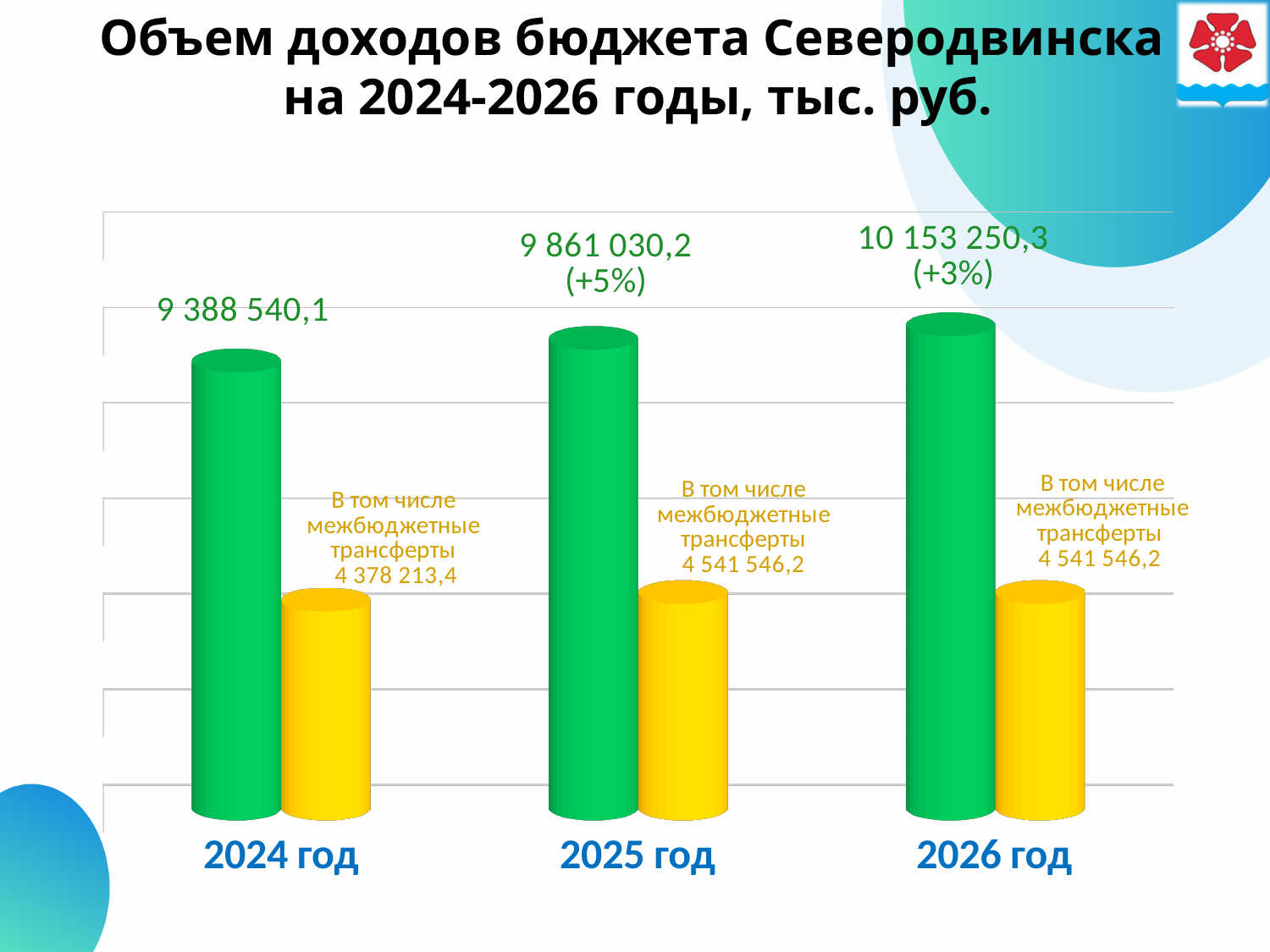
Do the total budget revenue values rise or fall from 2024 год to 2026 год? Rise What percentage growth is shown next to the 2025 год total revenue? +5% Which year has the lowest total budget revenue? 2024 год What is the total budget revenue shown for 2025 год? 9 861 030,2 Which year has the highest total budget revenue? 2026 год Which is larger: the total revenue for 2024 год or the межбюджетные трансферты for 2024 год? Total revenue for 2024 год What is the difference between the total budget revenue for 2025 год and 2024 год? 472 490,1 What is the total budget revenue shown for 2024 год? 9 388 540,1 What is the total budget revenue shown for 2026 год? 10 153 250,3 How many years (categories) are shown on the chart? 3 What is the value of межбюджетные трансферты for 2025 год? 4 541 546,2 What is the value of межбюджетные трансферты (intergovernmental transfers) for 2024 год? 4 378 213,4